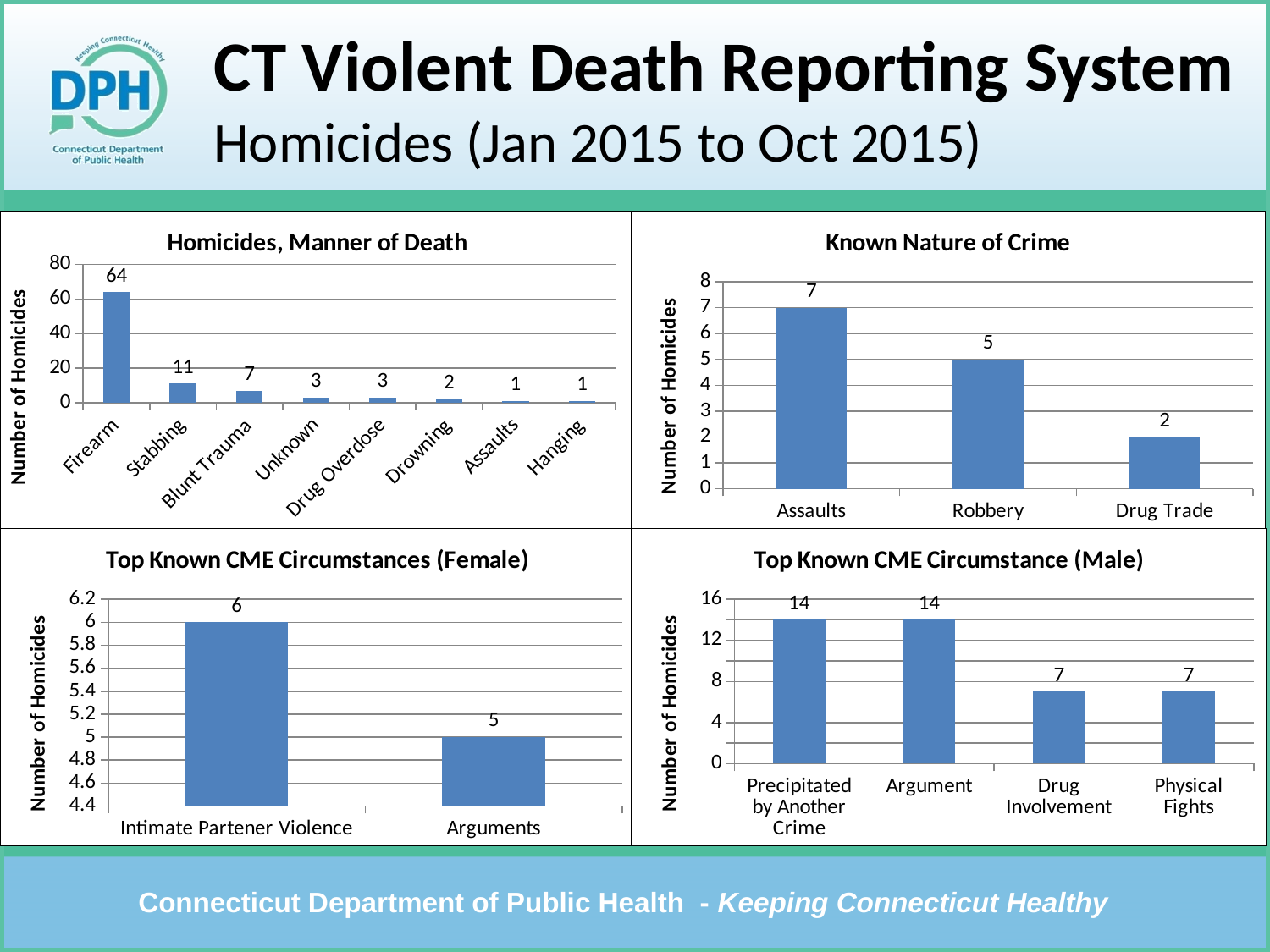
In the 'Homicides, Manner of Death' chart, what is the difference between the number of homicides by firearm and by stabbing? 53 In the 'Top Known CME Circumstances (Female)' chart, how many homicides are attributed to intimate partner violence? 6 In the 'Known Nature of Crime' chart, which category has the lowest number of homicides? Drug Trade In the 'Top Known CME Circumstance (Male)' chart, what is the difference between the values for Argument and Physical Fights? 7 What type of chart is the 'Top Known CME Circumstance (Male)' chart? bar chart In the 'Top Known CME Circumstances (Female)' chart, which is larger, Intimate Partener Violence or Arguments? Intimate Partener Violence In the 'Homicides, Manner of Death' chart, how many homicides were by firearm? 64 In the 'Homicides, Manner of Death' chart, how many categories are shown on the x axis? 8 In the 'Top Known CME Circumstance (Male)' chart, how many homicides are attributed to drug involvement? 7 In the 'Known Nature of Crime' chart, how many homicides are attributed to robbery? 5 In the 'Known Nature of Crime' chart, do the values rise or fall from left to right along the x axis? fall In the 'Homicides, Manner of Death' chart, which manner of death has the highest number of homicides? Firearm